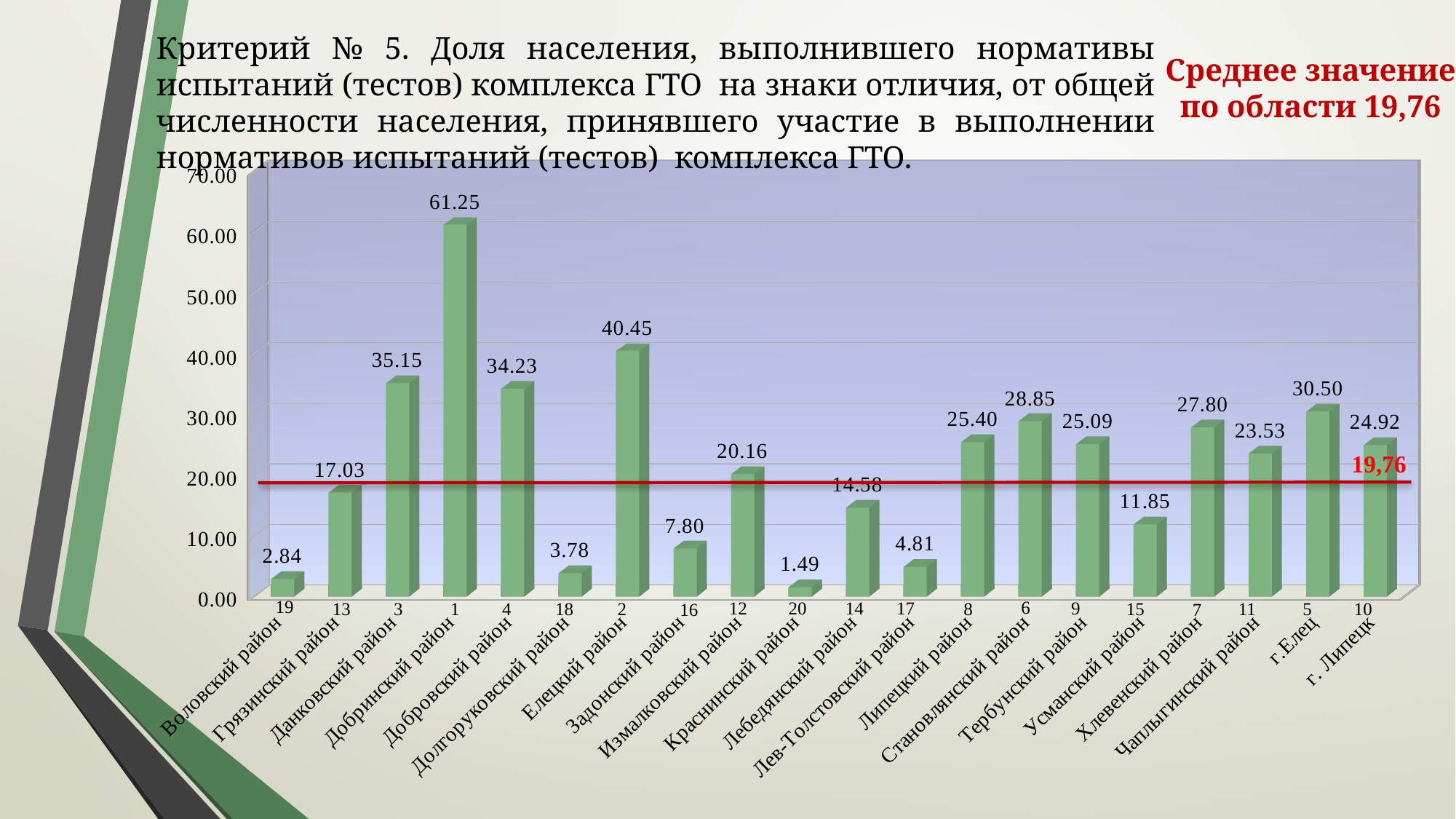
What rank number is printed above the axis label for Елецкий район? 2 Which is larger, the value for Становлянский район or the value for Хлевенский район? Становлянский район What value is shown for г. Липецк? 24.92 What is the difference between the values for Елецкий район and Данковский район? 5.30 How many districts (categories) are shown on the chart? 20 What kind of chart is shown on the slide? bar chart Which district has the highest value on the chart? Добринский район Is the value for Усманский район greater or less than 20.00? less What value does the red horizontal line on the chart mark? 19,76 What value is shown for Краснинский район? 1.49 Which district has the lowest value on the chart? Краснинский район What value is shown for Добринский район? 61.25